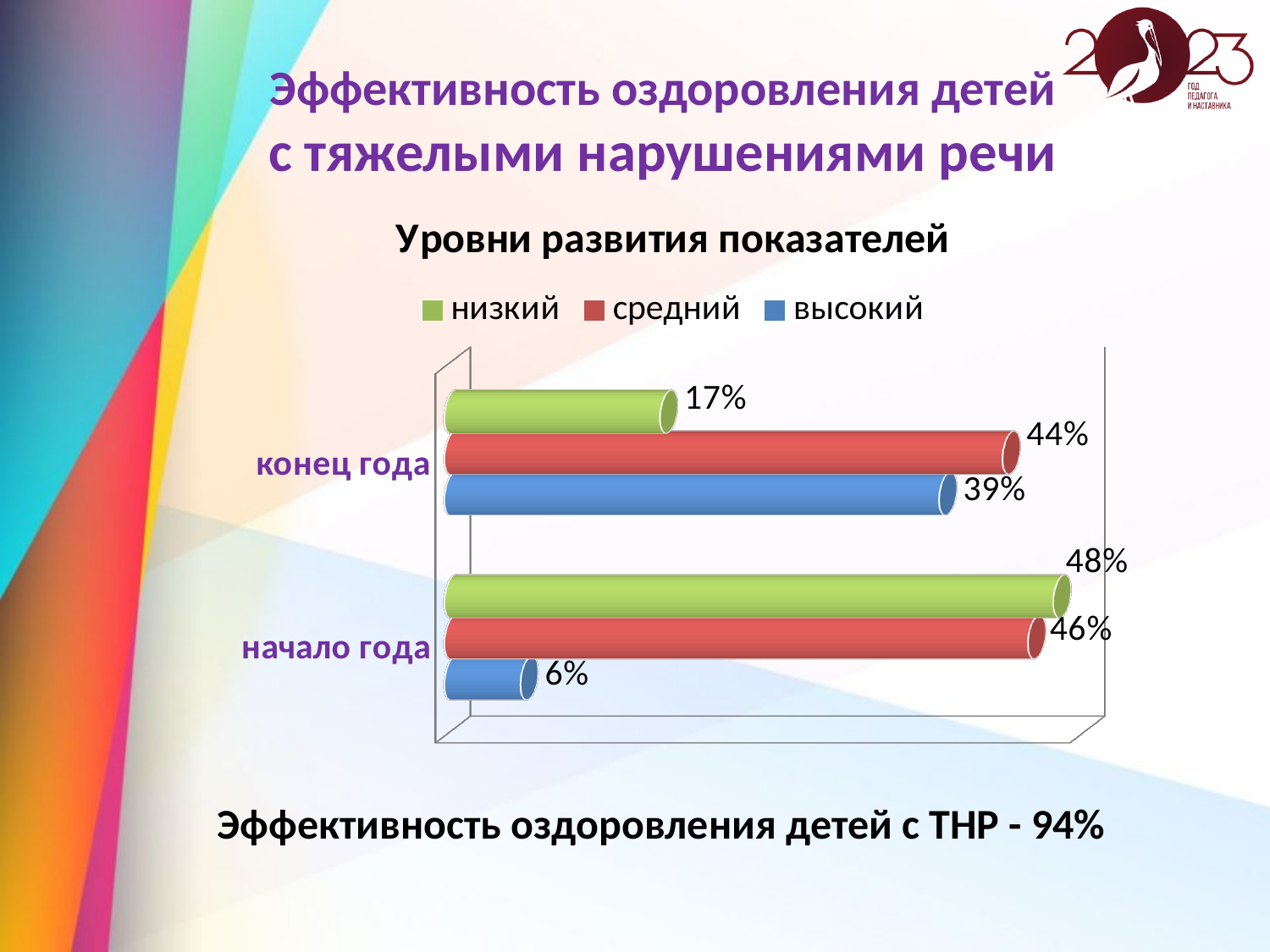
What is the value for "высокий" at "начало года"? 6% How many series does the legend list? 3 Which series has the highest value at "начало года"? низкий What is the value for "средний" at "конец года"? 44% Which is larger at "конец года": "средний" or "высокий"? средний How many categories are shown on the chart? 2 What is the difference between the "высокий" values at "конец года" and "начало года"? 33% What is the value for "низкий" at "начало года"? 48% What is the title of the chart? Уровни развития показателей What kind of chart is shown on the slide? bar chart Which series has the lowest value at "конец года"? низкий What is the value for "низкий" at "конец года"? 17%